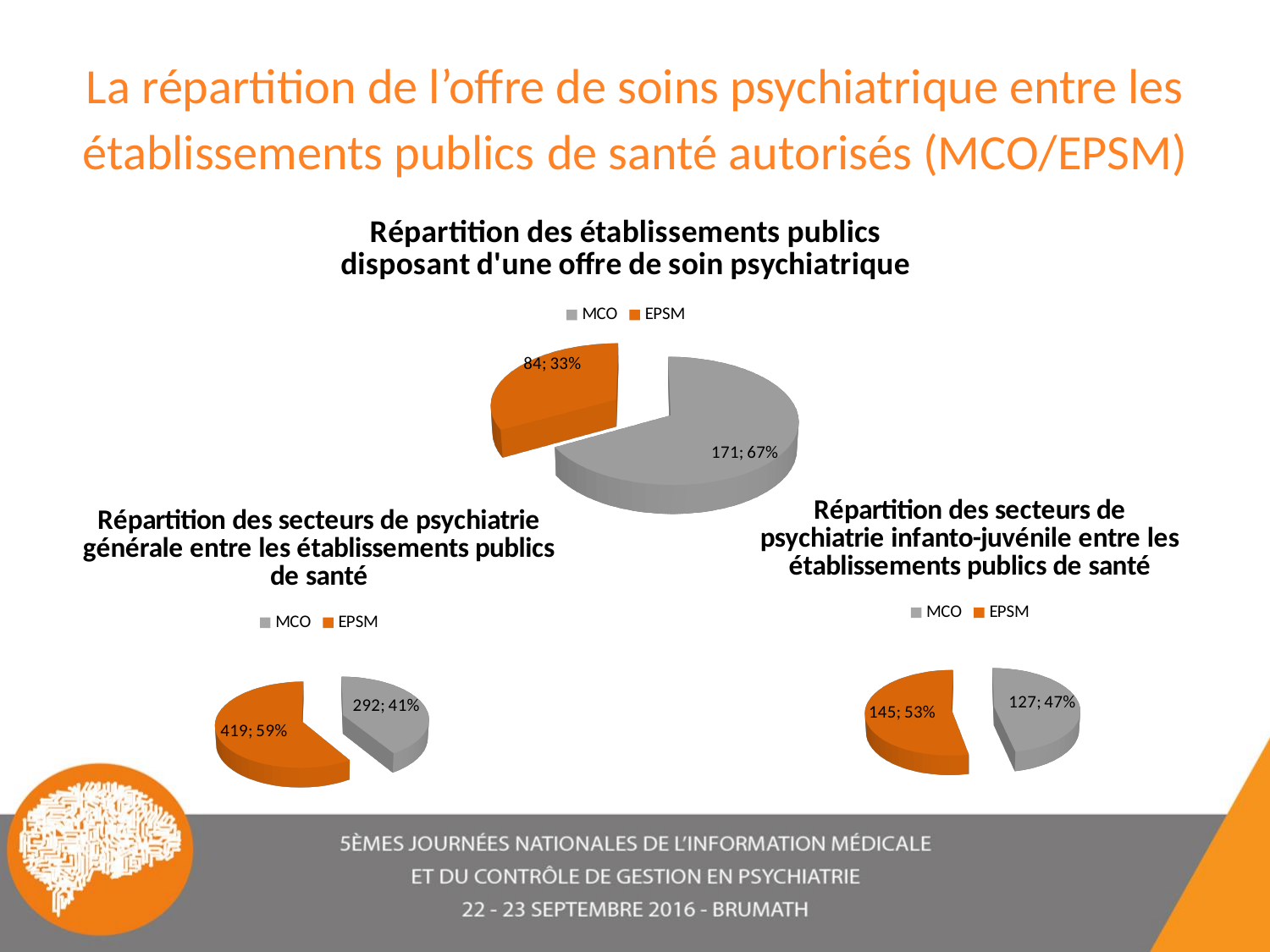
In the bottom-left chart 'Répartition des secteurs de psychiatrie générale entre les établissements publics de santé', what value is shown for EPSM? 419; 59% In the bottom-left chart 'Répartition des secteurs de psychiatrie générale entre les établissements publics de santé', what value is shown for MCO? 292; 41% In the bottom-right chart 'Répartition des secteurs de psychiatrie infanto-juvénile entre les établissements publics de santé', what value is shown for EPSM? 145; 53% In the bottom-right chart 'Répartition des secteurs de psychiatrie infanto-juvénile entre les établissements publics de santé', which is larger, MCO or EPSM? EPSM In the bottom-left chart 'Répartition des secteurs de psychiatrie générale entre les établissements publics de santé', how many categories does the legend list? 2 In the top chart 'Répartition des établissements publics disposant d'une offre de soin psychiatrique', what value is shown for EPSM? 84; 33% In the top chart 'Répartition des établissements publics disposant d'une offre de soin psychiatrique', what share of the pie does EPSM represent? 33% In the top chart 'Répartition des établissements publics disposant d'une offre de soin psychiatrique', which category has the largest slice? MCO In the bottom-right chart 'Répartition des secteurs de psychiatrie infanto-juvénile entre les établissements publics de santé', what value is shown for MCO? 127; 47% In the top chart 'Répartition des établissements publics disposant d'une offre de soin psychiatrique', what value is shown for MCO? 171; 67% In the bottom-left chart 'Répartition des secteurs de psychiatrie générale entre les établissements publics de santé', what is the difference between the EPSM count and the MCO count? 127 What kind of chart is the top chart 'Répartition des établissements publics disposant d'une offre de soin psychiatrique'? Pie chart